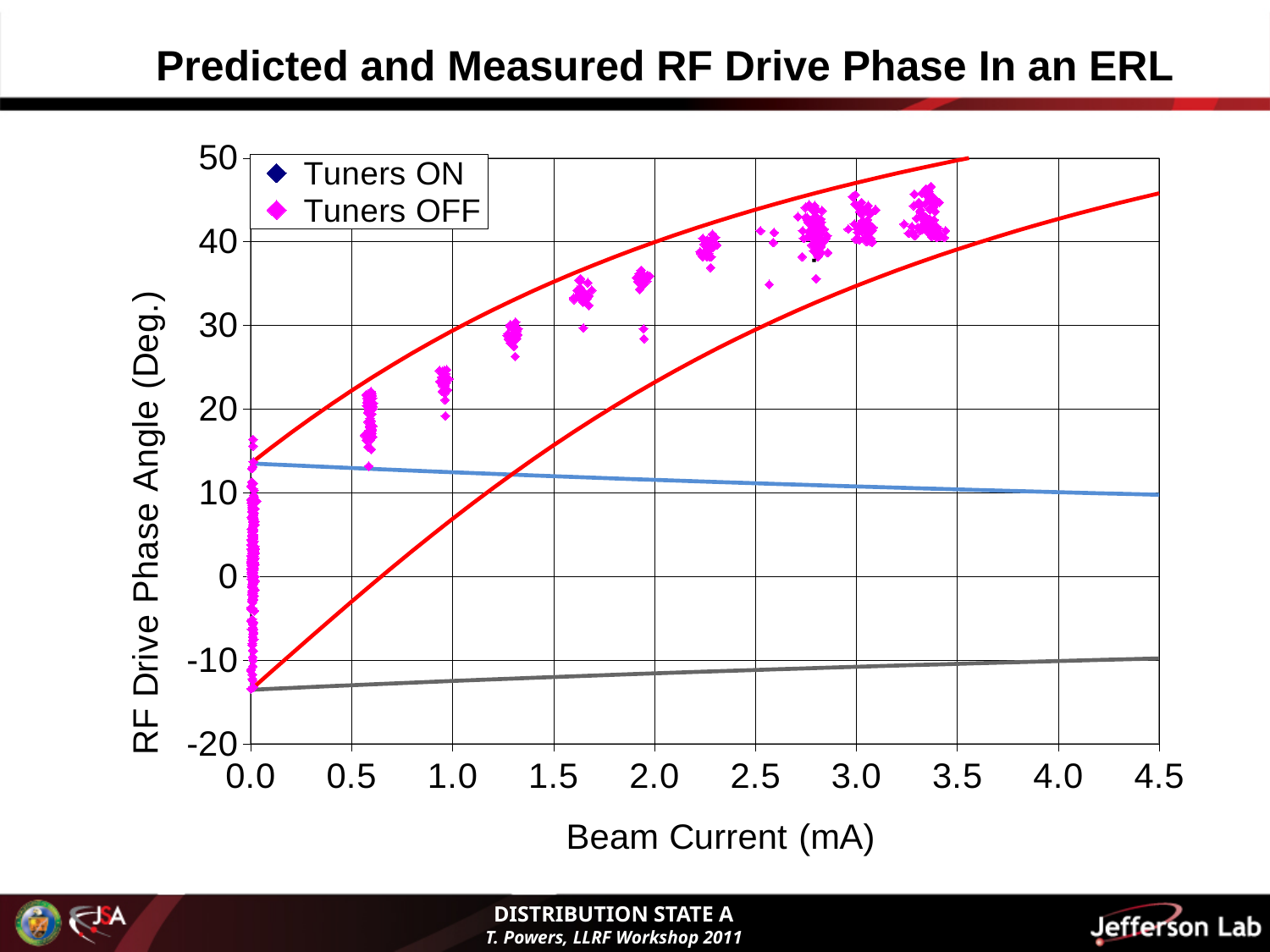
What is the label of the x axis? Beam Current (mA) What is the highest value shown on the y axis? 50 Are the Tuners OFF values at a beam current of 3.0 mA greater or less than 30? greater What is the highest beam current value shown on the x axis? 4.5 What kind of chart is shown on the slide? scatter chart What is the title of the chart? Predicted and Measured RF Drive Phase In an ERL Does the blue line rise or fall as beam current increases from 0.0 to 4.5 mA? fall How many series does the legend list? 2 Are the Tuners OFF values at a beam current of 1.0 mA greater or less than 30? less What is the lowest value shown on the y axis? -20 Do the Tuners OFF data points rise or fall as beam current increases? rise Does the grey line near the bottom of the chart rise or fall as beam current increases? rise